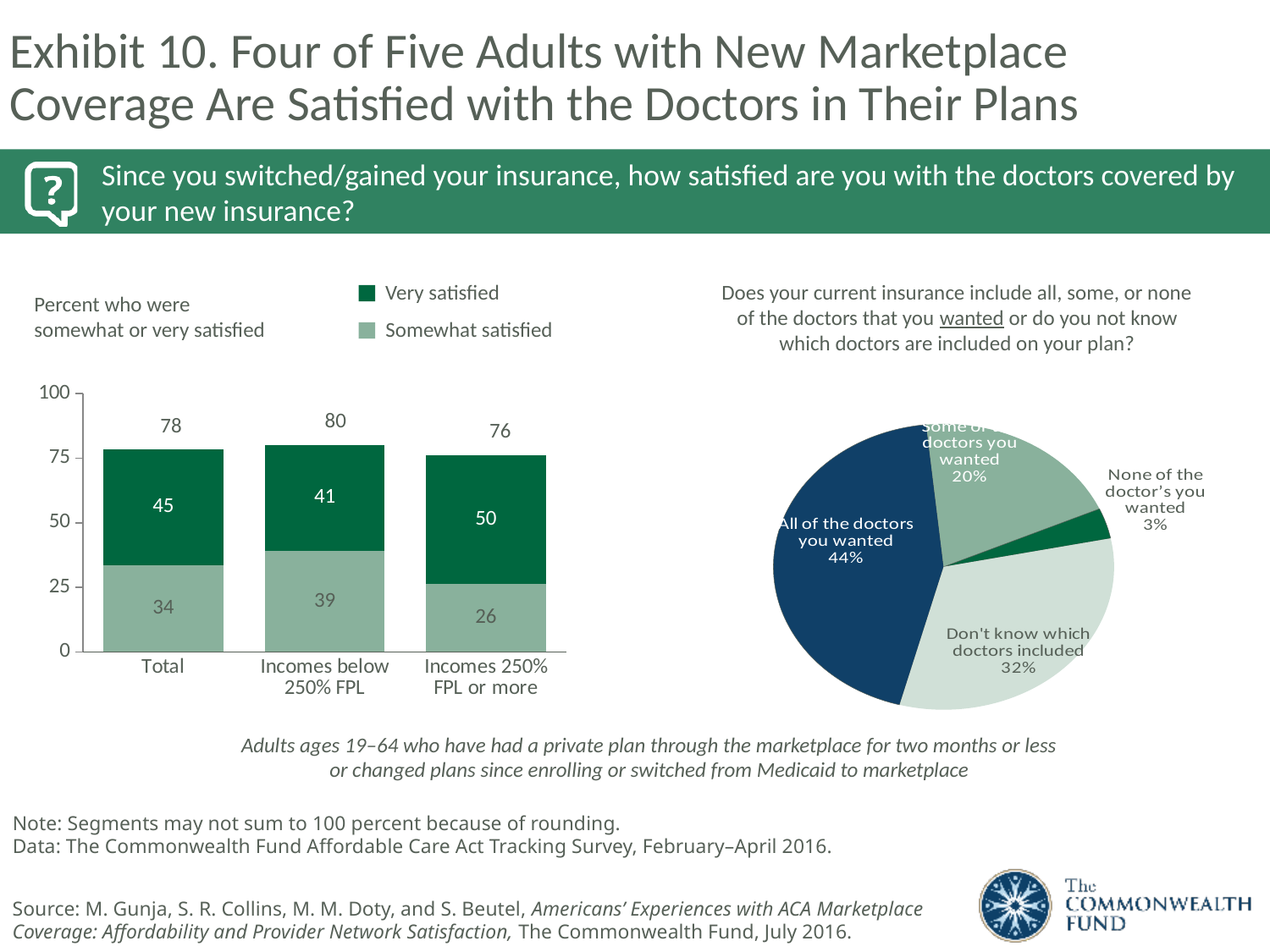
In the bar chart on the left, what is the 'Somewhat satisfied' value for Incomes below 250% FPL? 39 In the pie chart on the right, what share of respondents said their insurance includes all of the doctors they wanted? 44% In the bar chart on the left, is the 'Very satisfied' value larger for Total or for Incomes below 250% FPL? Total In the bar chart on the left, which income group has the highest total percent somewhat or very satisfied? Incomes below 250% FPL What type of chart is shown on the right side of the slide? Pie chart In the bar chart on the left, what is the 'Very satisfied' value for Incomes 250% FPL or more? 50 How many series does the legend of the bar chart on the left list? 2 In the pie chart on the right, which response has the smallest share? None of the doctor's you wanted In the bar chart on the left, what is the total percent somewhat or very satisfied for the Total group? 78 In the bar chart on the left, what is the difference between the 'Very satisfied' values for Incomes 250% FPL or more and Incomes below 250% FPL? 9 In the bar chart on the left, which category has the lowest 'Somewhat satisfied' value? Incomes 250% FPL or more How many categories are shown on the x axis of the bar chart on the left? 3